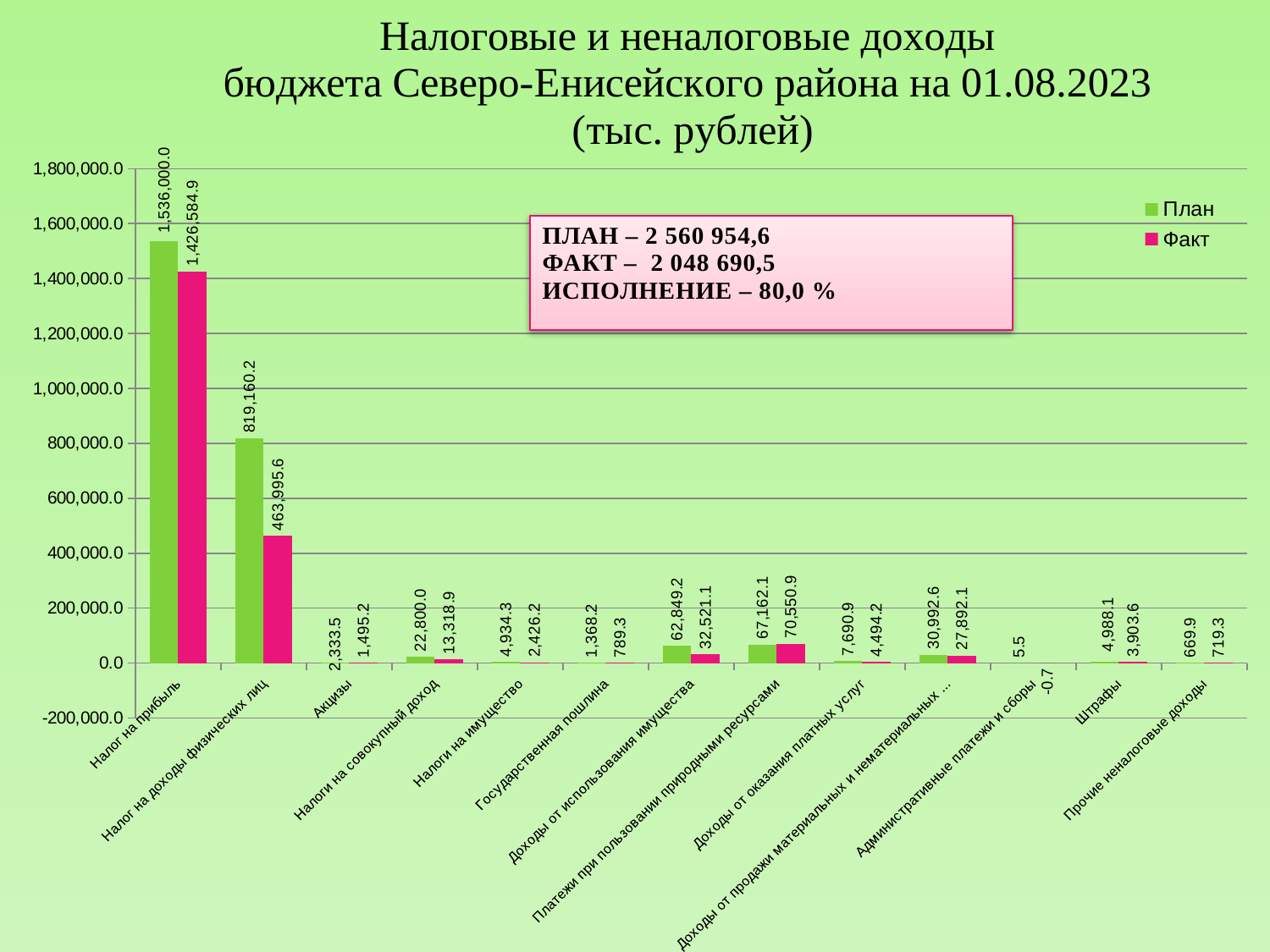
Which category has the highest План value? Налог на прибыль What is the difference between План and Факт for Налог на доходы физических лиц? 355,164.6 What is the План value for Налоги на совокупный доход? 22,800.0 What is the Факт value for Налог на прибыль? 1,426,584.9 What is the difference between План and Факт for Доходы от использования имущества? 30,328.1 What is the Факт value for Штрафы? 3,903.6 Which category has the lowest Факт value? Административные платежи и сборы What execution percentage (ИСПОЛНЕНИЕ) is stated in the text box on the chart? 80,0 % How many categories are shown on the x axis? 13 What kind of chart is shown on the slide? bar chart For Платежи при пользовании природными ресурсами, which is larger: План or Факт? Факт How many series does the legend list? 2